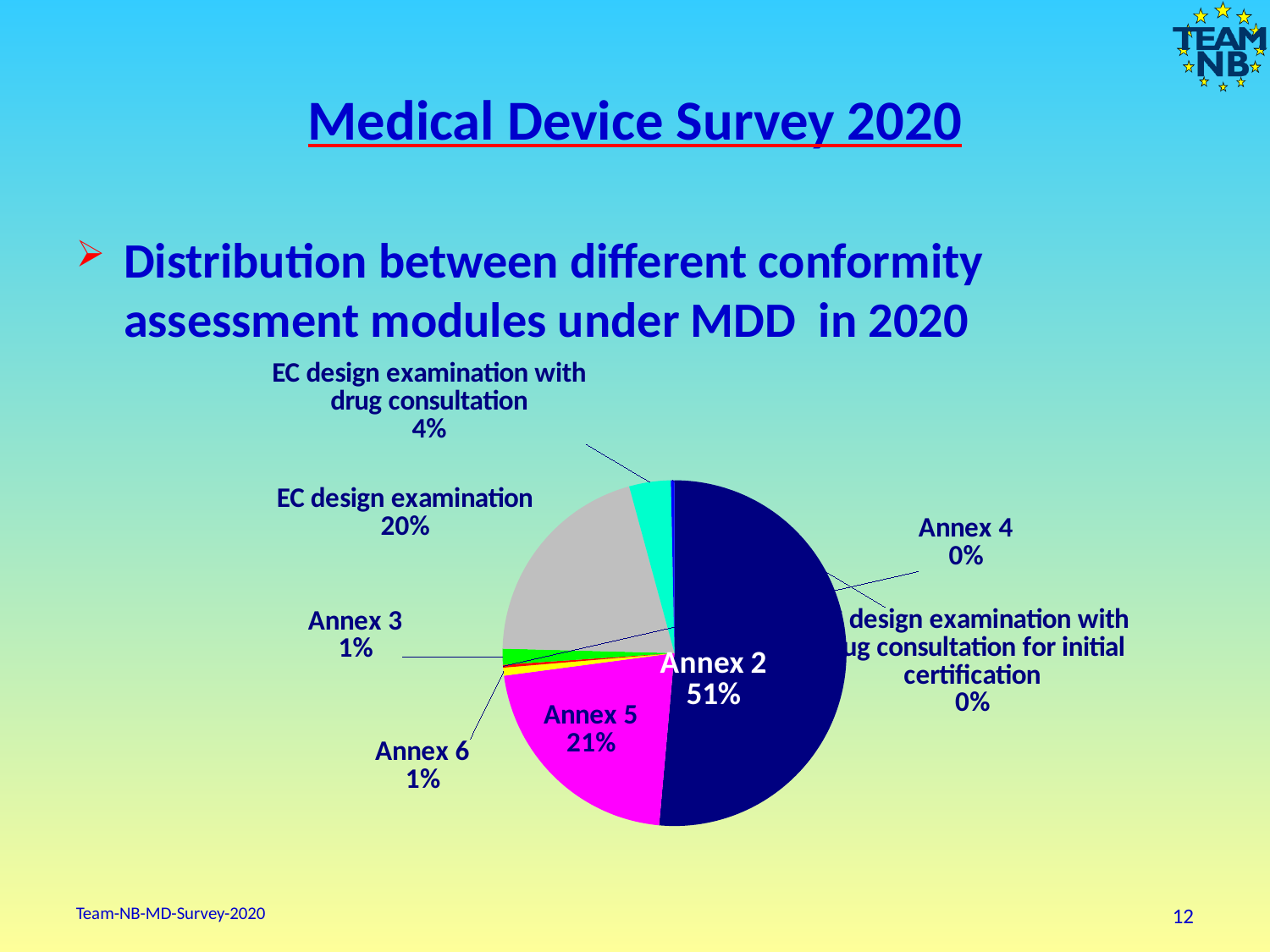
Which is larger, the share for Annex 5 or the share for EC design examination? Annex 5 Which category has the largest share of the pie? Annex 2 What colour is the Annex 5 slice of the pie? Magenta How many categories are labelled on the pie chart? 8 What kind of chart is shown on the slide? Pie chart What percentage is shown for EC design examination with drug consultation? 4% What share of the pie does Annex 2 represent? 51% What share of the pie does Annex 5 represent? 21% What percentage is shown for EC design examination? 20% What percentage is shown for Annex 3? 1% What percentage is shown for Annex 4? 0% What is the difference in percentage points between Annex 2 and Annex 5? 30